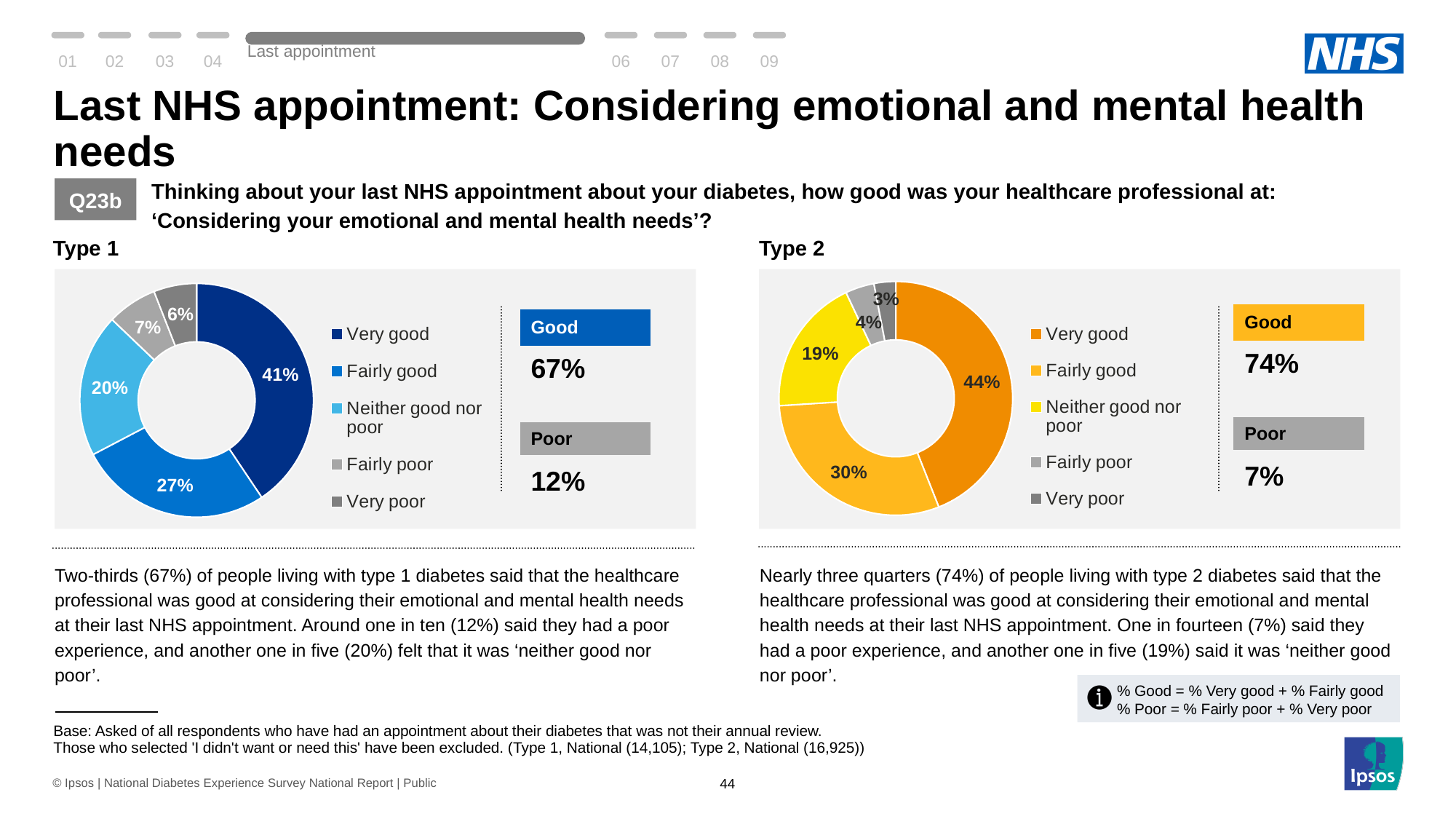
In the Type 2 chart, which category has the largest share? Very good In the Type 2 chart, what percentage of respondents said 'Very poor'? 3% How many categories does the Type 1 chart show? 5 In the Type 1 chart, what percentage of respondents said 'Neither good nor poor'? 20% What is the difference between the 'Very good' percentages for Type 1 and Type 2? 3 percentage points What is the combined 'Good' percentage shown for Type 2? 74% What colour represents 'Very good' in the Type 1 chart? Dark blue In the Type 2 chart, what percentage of respondents said 'Fairly good'? 30% What kind of chart is used for Type 2? Doughnut chart Which is larger: the 'Fairly poor' share for Type 1 or for Type 2? Type 1 In the Type 1 chart, what percentage of respondents said 'Very good'? 41% In the Type 1 chart, which category has the smallest share? Very poor